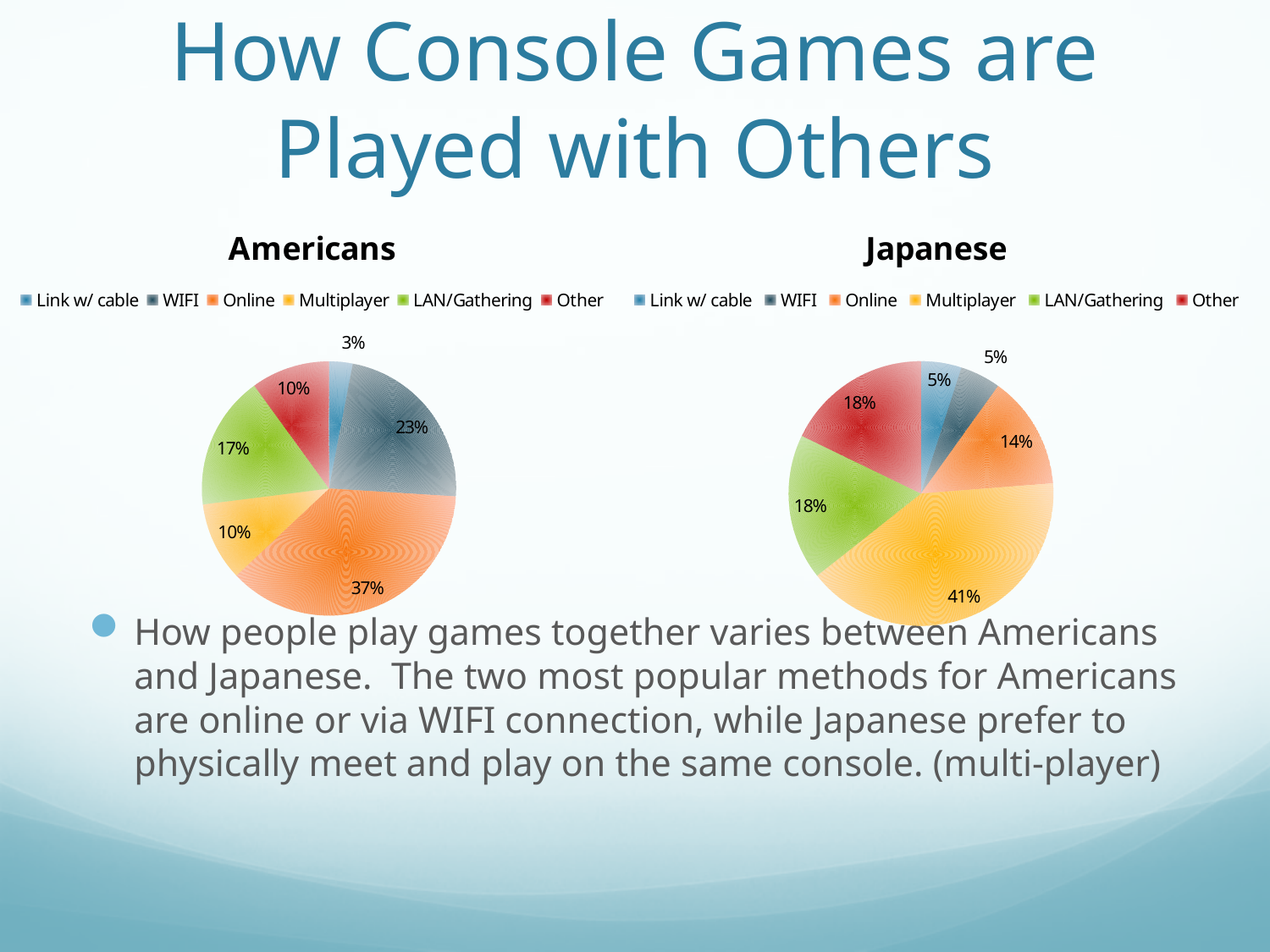
Which is larger: the LAN/Gathering share in the Americans chart or in the Japanese chart? Japanese In the Japanese pie chart, which category has the largest share? Multiplayer In the Americans pie chart, what share is Online? 37% In the Americans pie chart, which category has the smallest share? Link w/ cable In the Japanese pie chart, what share is Online? 14% What type of chart is used for the Americans and Japanese data? Pie chart In the Americans pie chart, which category has the largest share? Online In the Japanese pie chart, what share is Multiplayer? 41% What is the difference between the Multiplayer share in the Japanese chart and the Multiplayer share in the Americans chart? 31% In the Americans pie chart, what share is WIFI? 23% In the legend, which colour represents Other? Red How many categories does each pie chart show? 6